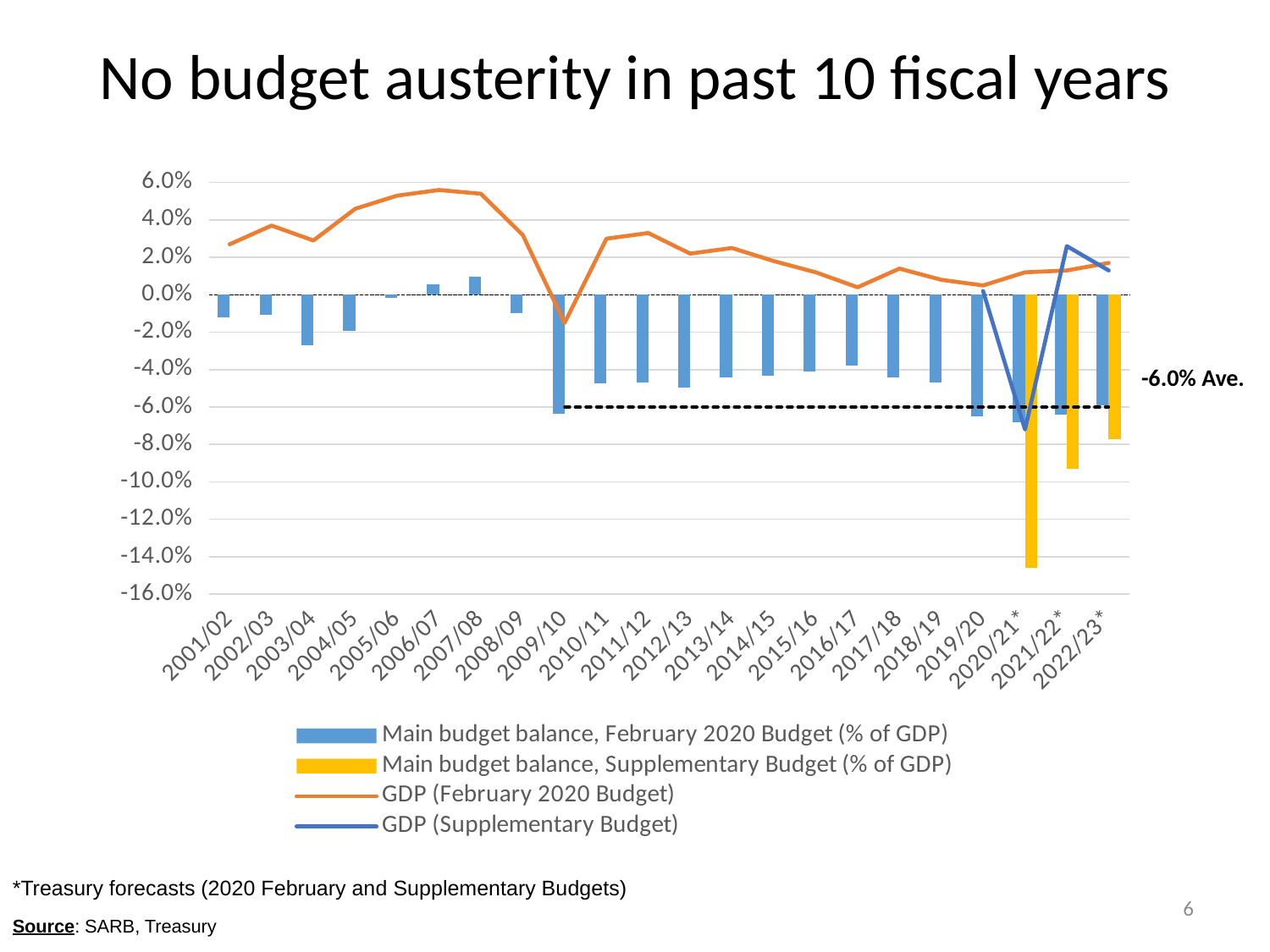
Which fiscal year has the highest (most positive) Main budget balance, February 2020 Budget bar? 2007/08 How many fiscal years are shown on the x axis of the chart? 22 How many fiscal years have a Main budget balance, Supplementary Budget bar? 3 Which fiscal year has the lowest Main budget balance, Supplementary Budget (% of GDP) bar? 2020/21* How many series does the chart legend list? 4 Does the GDP (Supplementary Budget) line rise or fall from 2019/20 to 2020/21*? fall What average value is marked by the dashed horizontal line and its label on the chart? -6.0% Ave. Is the Main budget balance, Supplementary Budget value for 2020/21* greater or less than -14.0%? less Is the Main budget balance, Supplementary Budget value for 2021/22* greater or less than -8.0%? less Is the GDP (February 2020 Budget) value for 2006/07 greater or less than 4.0%? greater What kind of chart is shown on the slide? Combined bar and line chart For 2020/21*, which series shows the larger deficit: Main budget balance, February 2020 Budget or Main budget balance, Supplementary Budget? Main budget balance, Supplementary Budget